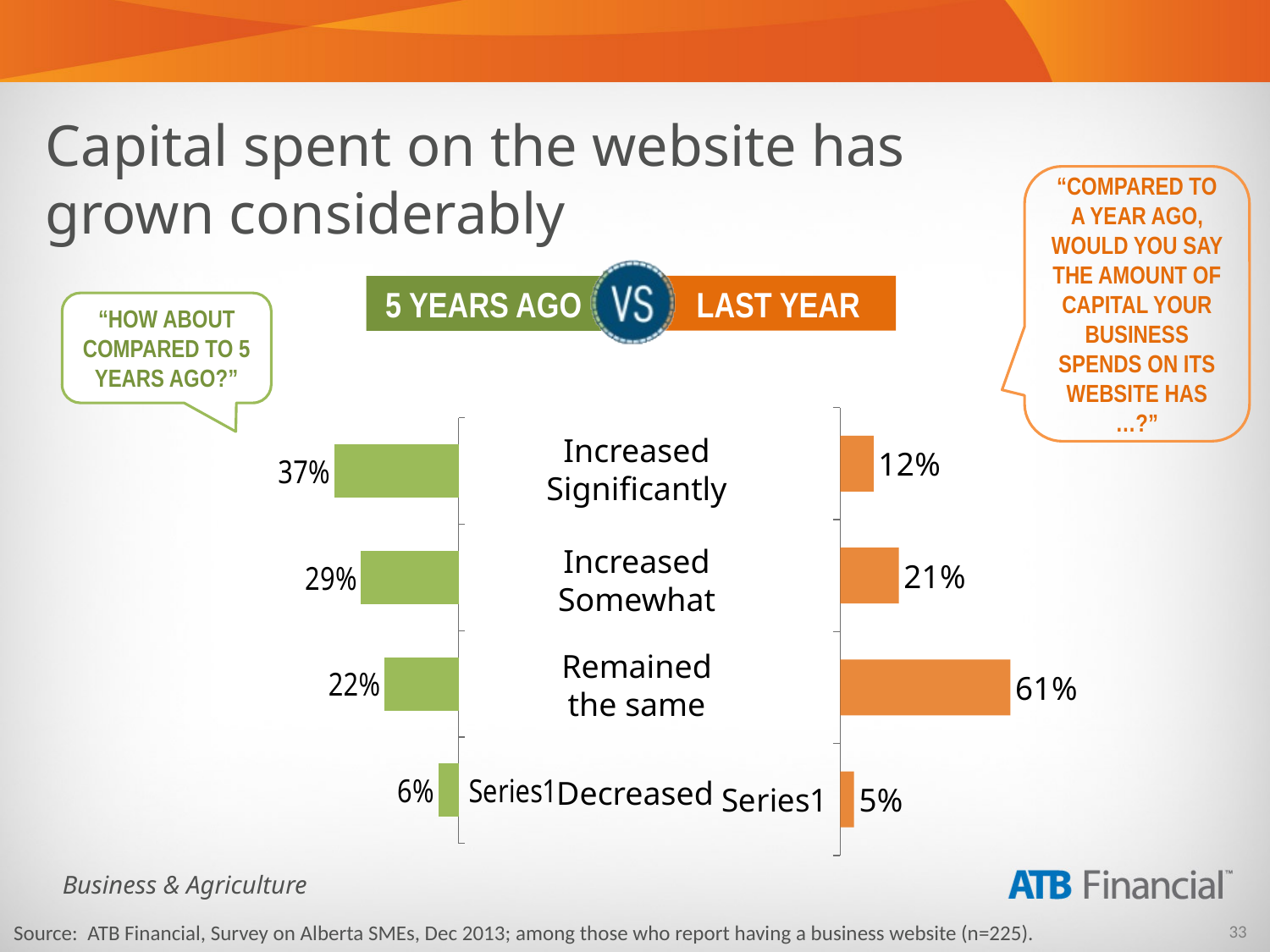
What type of chart is used for the 'last year' data? Bar chart In the 'last year' chart, what is the value for 'Increased Somewhat'? 21% In the '5 years ago' chart, which category has the lowest value? Decreased In the 'last year' chart, what percentage said capital spent on the website remained the same? 61% In the '5 years ago' chart, what percentage said capital spent on the website increased significantly? 37% How many categories are shown in the '5 years ago' chart? 4 What is the difference between the 'Remained the same' values in the 'last year' chart and the '5 years ago' chart? 39 percentage points In the '5 years ago' chart, which category has the highest value? Increased Significantly Which is larger: 'Increased Significantly' in the '5 years ago' chart or 'Increased Significantly' in the 'last year' chart? 5 years ago In the '5 years ago' chart, what is the value for 'Decreased'? 6% In the 'last year' chart, which category has the highest value? Remained the same What colour are the bars in the '5 years ago' chart? Green